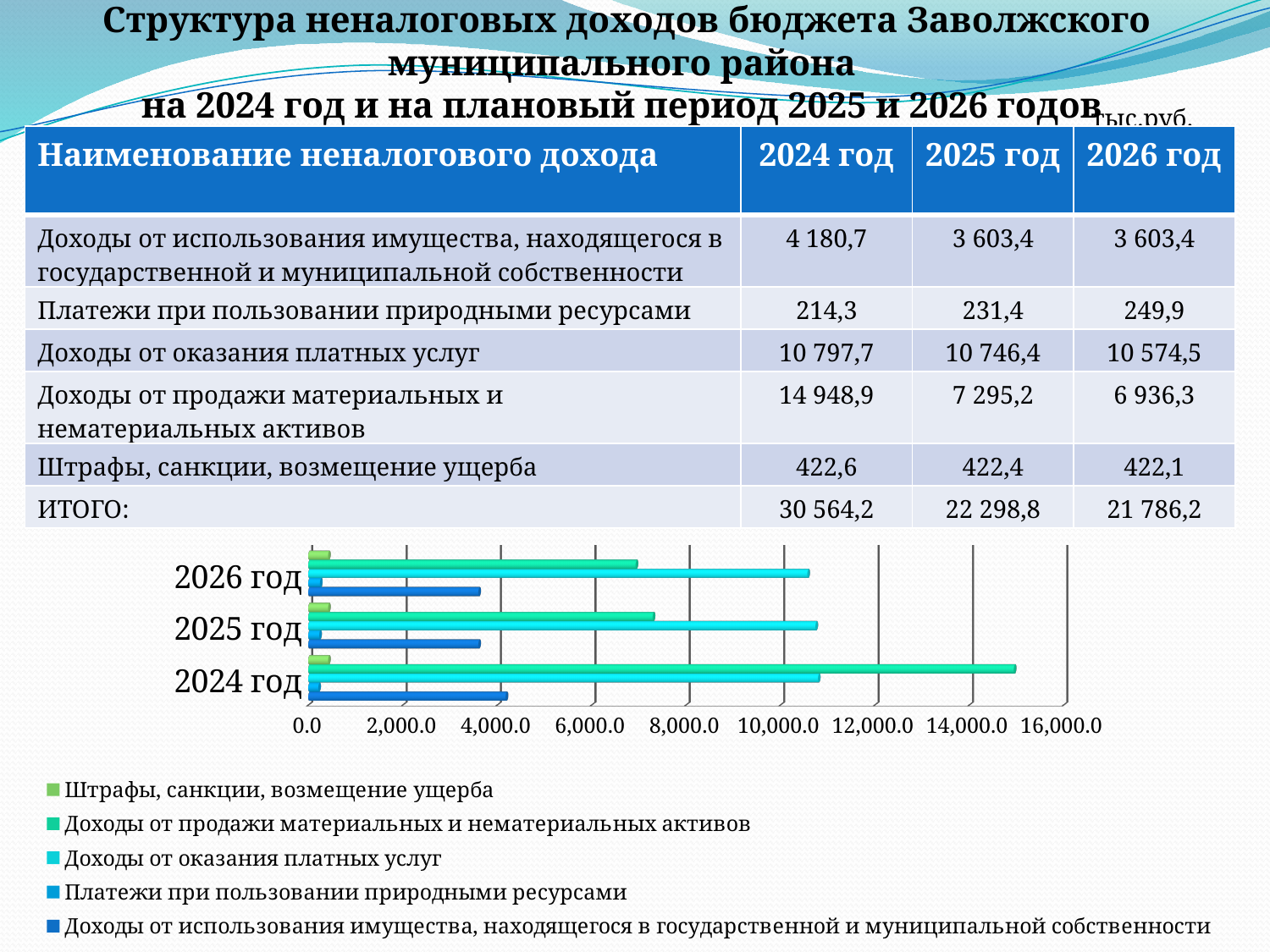
Is the bar for 'Доходы от оказания платных услуг' in 2026 год greater or less than 10,000.0? greater According to the table, what is the total (ИТОГО) for 2026 год? 21 786,2 According to the table, what is the value of 'Доходы от продажи материальных и нематериальных активов' for 2024 год? 14 948,9 Is the bar for 'Доходы от использования имущества, находящегося в государственной и муниципальной собственности' in 2025 год greater or less than 4,000.0? less Is the bar for 'Доходы от продажи материальных и нематериальных активов' in 2024 год greater or less than 14,000.0? greater What kind of chart is shown on the slide? bar chart How many series does the chart legend list? 5 Which year has the longest bar for 'Доходы от продажи материальных и нематериальных активов'? 2024 год How many year categories are shown on the chart's vertical axis? 3 Which is larger in 2026 год: the bar for 'Доходы от оказания платных услуг' or the bar for 'Доходы от продажи материальных и нематериальных активов'? Доходы от оказания платных услуг Does the bar for 'Доходы от продажи материальных и нематериальных активов' rise or fall from 2024 год to 2026 год? fall What is the highest tick value shown on the chart's horizontal axis? 16,000.0